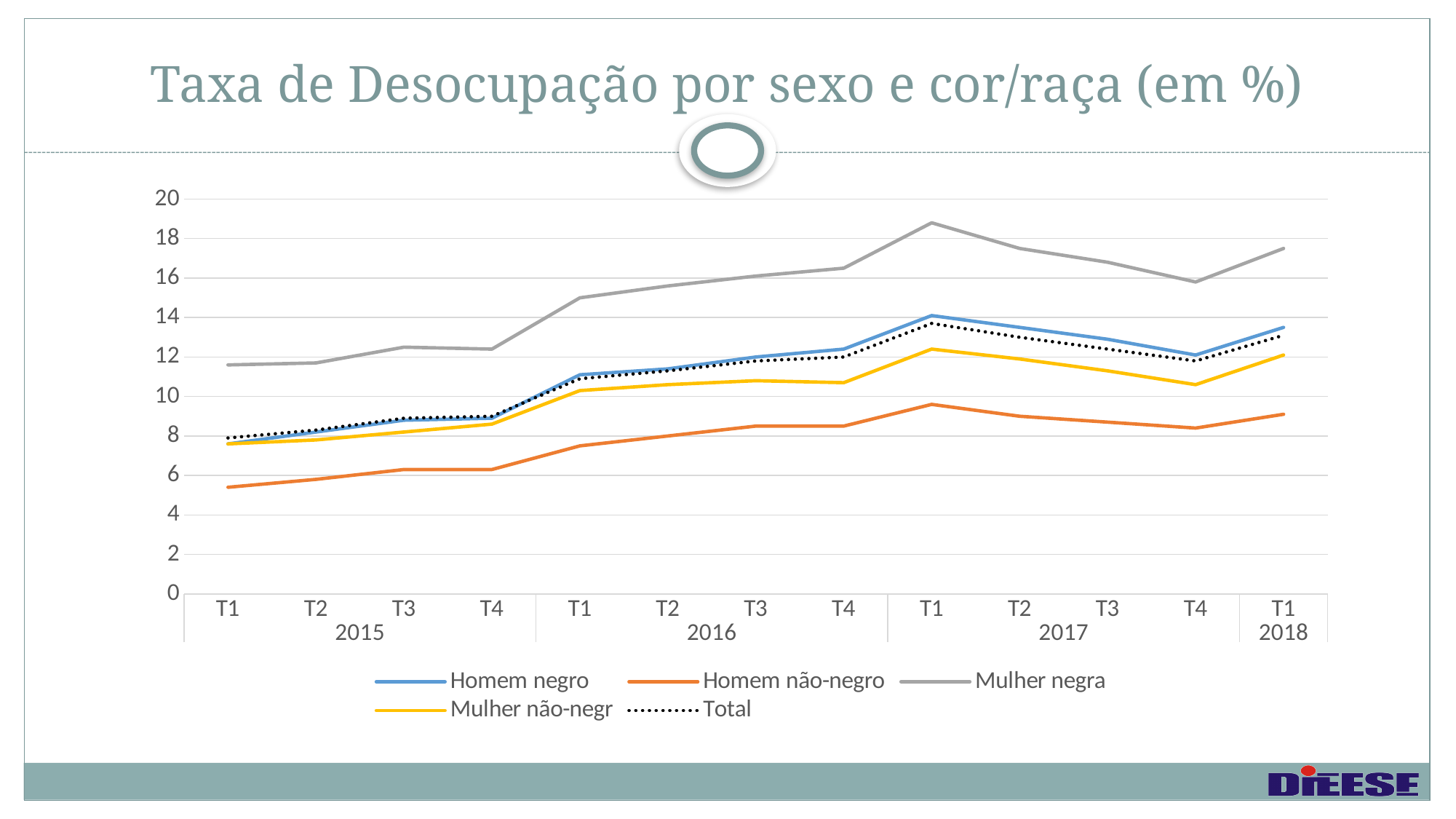
Which series has the lowest values across the whole period? Homem não-negro In which quarter does the Mulher negra series reach its highest value? T1 2017 Is the value for Homem não-negro in T1 2015 greater or less than 6? less In T1 2018, which is larger: Mulher negra or Homem negro? Mulher negra How many quarterly points are plotted along the x axis? 13 Which series has the highest values across the whole period? Mulher negra Is the value for Mulher não-negra in T4 2017 greater or less than 12? less How many series does the legend list? 5 Do the values for Mulher negra rise or fall from T1 2015 to T1 2017? rise What is the title of the chart? Taxa de Desocupação por sexo e cor/raça (em %) What kind of chart is shown on the slide? line chart Is the value for Mulher negra in T1 2017 greater or less than 18? greater